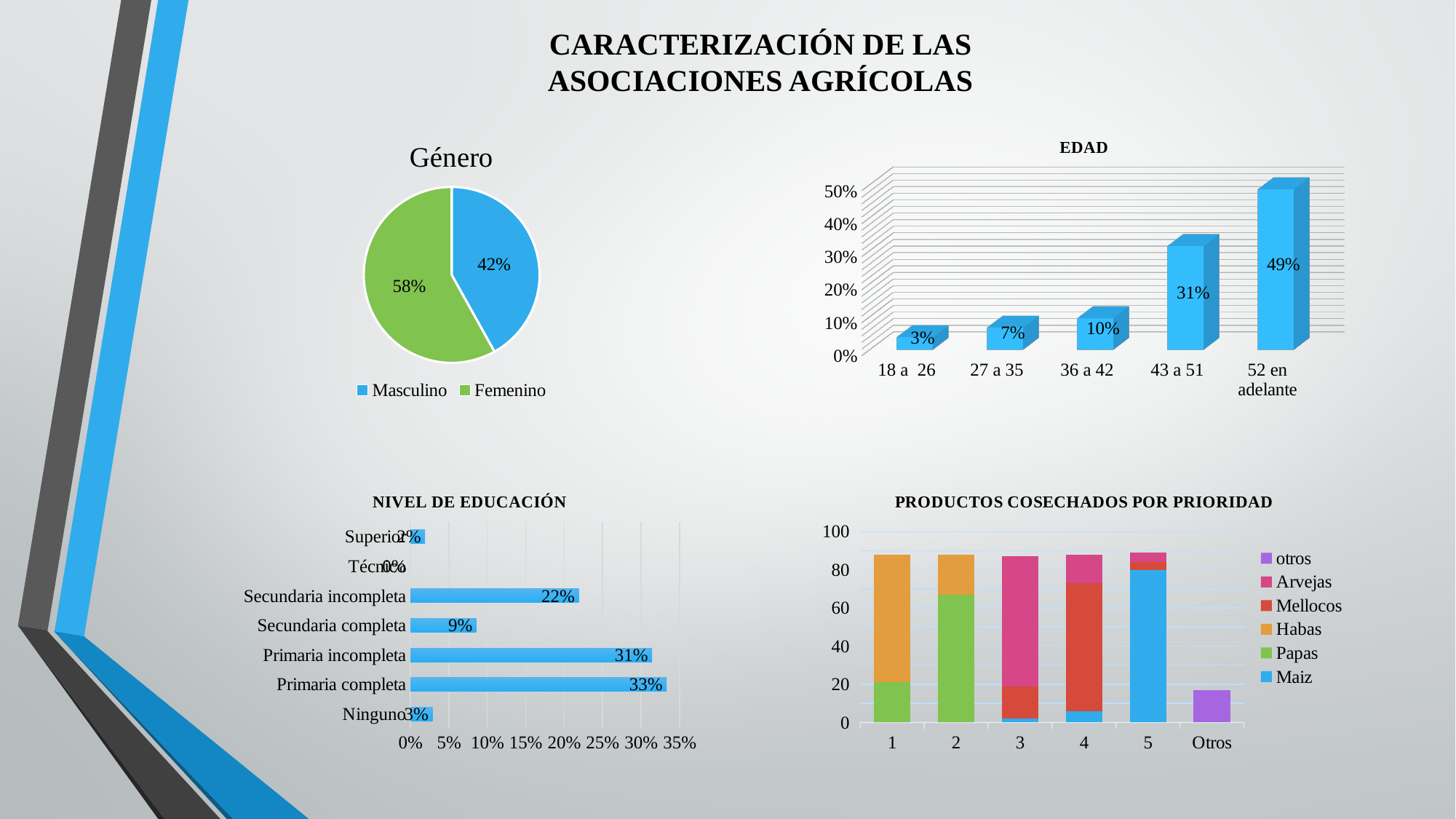
In the NIVEL DE EDUCACIÓN chart, which is larger, Secundaria incompleta or Secundaria completa? Secundaria incompleta In the PRODUCTOS COSECHADOS POR PRIORIDAD chart, how many series does the legend list? 6 In the NIVEL DE EDUCACIÓN chart, which category has the highest value? Primaria completa In the PRODUCTOS COSECHADOS POR PRIORIDAD chart, is the Otros bar greater or less than 20? less What kind of chart is the Género chart? Pie chart In the NIVEL DE EDUCACIÓN chart, what is the value for Primaria completa? 33% In the EDAD chart, what is the difference between the 43 a 51 group and the 36 a 42 group? 21% In the Género pie chart, what percentage is Masculino? 42% In the EDAD chart, how many age groups are shown? 5 In the EDAD chart, what is the value for the 52 en adelante group? 49% In the Género pie chart, what percentage is Femenino? 58% In the EDAD chart, which age group has the lowest value? 18 a 26